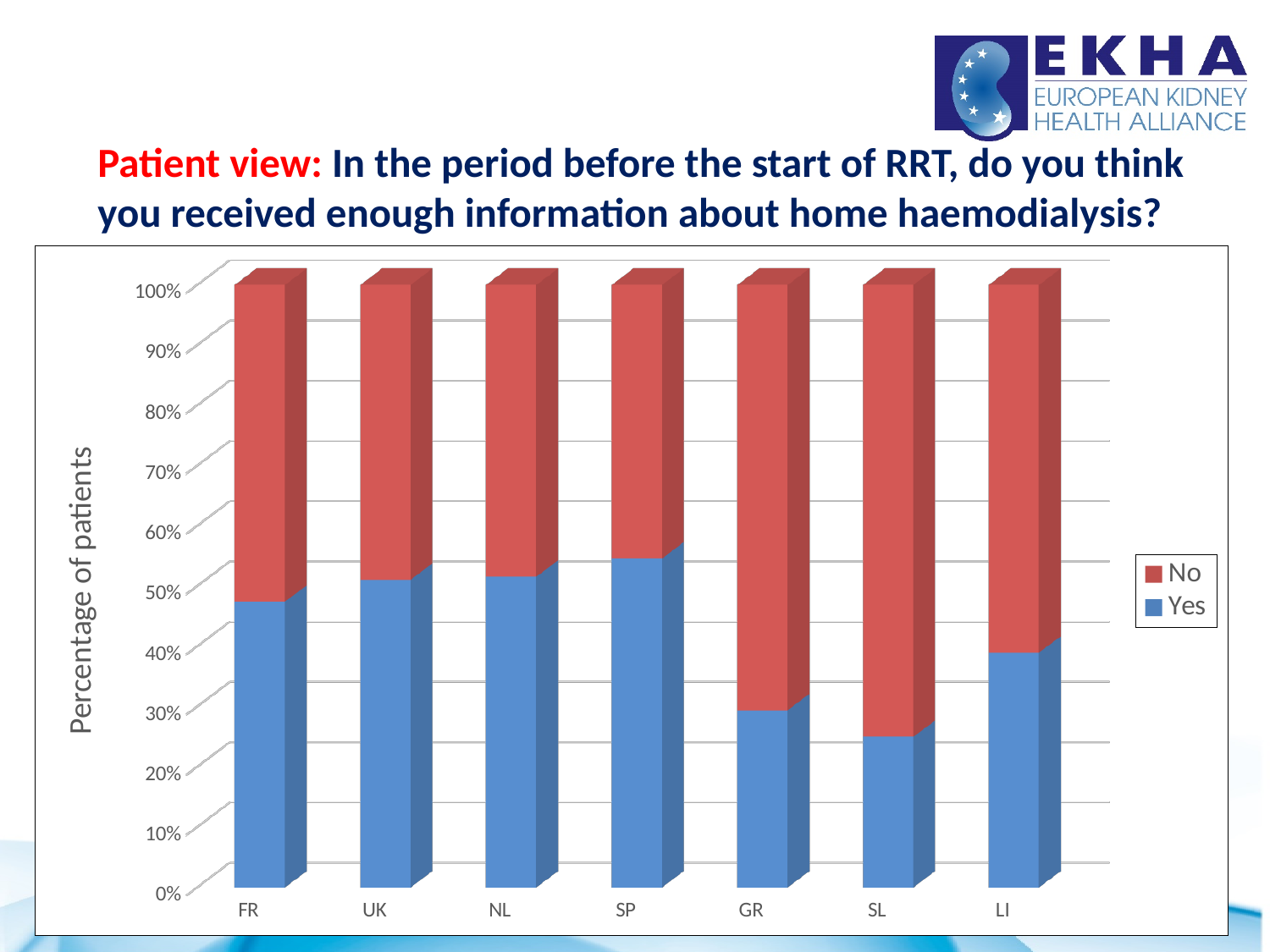
Which country has the lowest share of patients answering Yes? SL How many countries are shown on the x axis of the chart? 7 What is the label on the vertical axis of the chart? Percentage of patients What kind of chart is shown on the slide? Stacked bar chart Which country has the highest share of patients answering Yes? SP Which has a larger Yes share, GR or SL? GR Is the Yes value for GR greater or less than 40%? less Is the Yes value for LI greater or less than 50%? less How many series does the chart's legend list? 2 Which country has the largest share of patients answering No? SL Is the Yes value for SP greater or less than 50%? greater